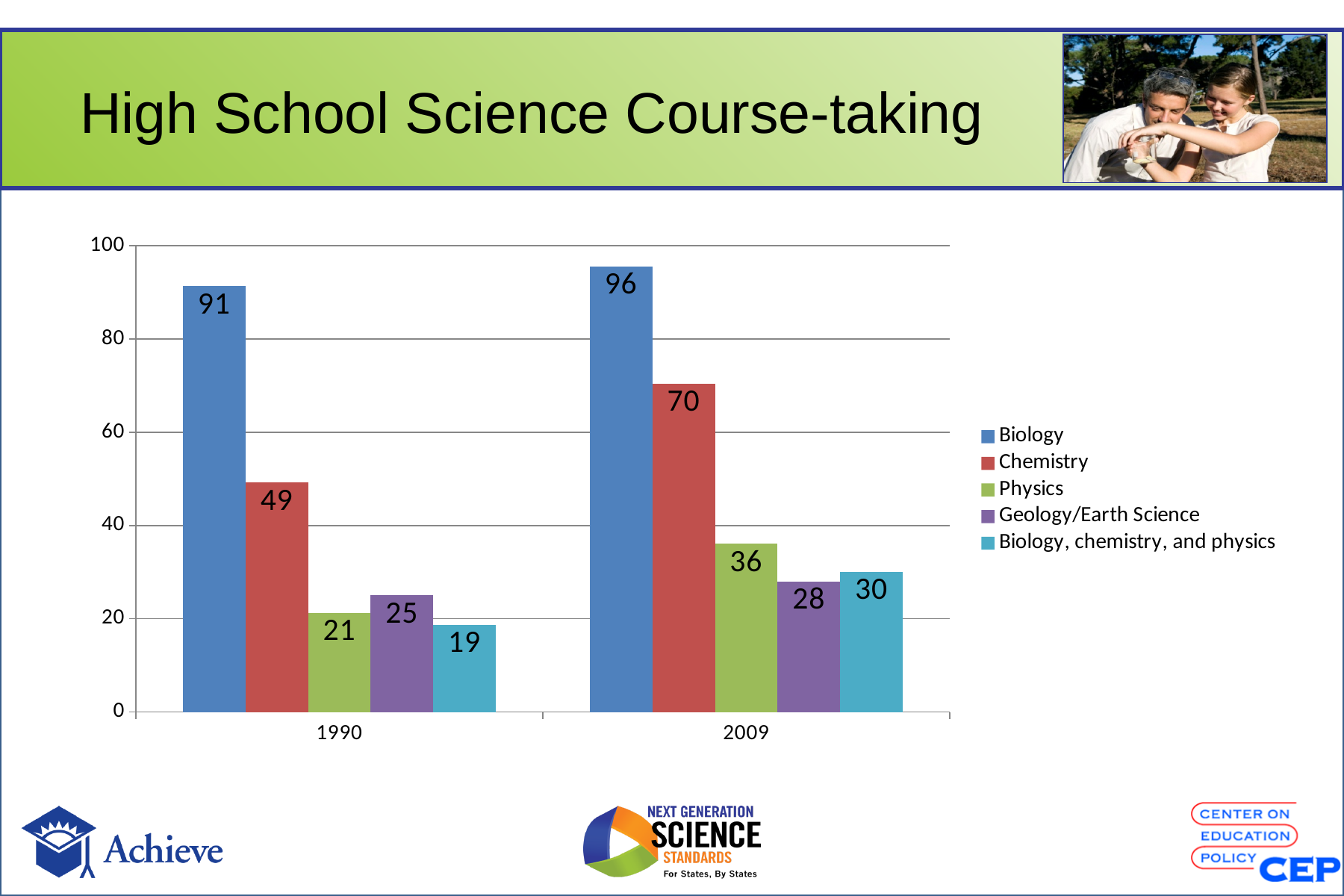
Does the Physics value rise or fall from 1990 to 2009? Rise What is the value for Chemistry in 2009? 70 What is the value for Biology, chemistry, and physics in 2009? 30 Which is larger, Physics in 2009 or Geology/Earth Science in 2009? Physics in 2009 Which series has the lowest value in 1990? Biology, chemistry, and physics How many series does the legend list? 5 What is the value for Biology in 1990? 91 Which series has the highest value in 2009? Biology What kind of chart is shown on the slide? Bar chart What is the difference between the Chemistry values for 2009 and 1990? 21 Is the value for Chemistry in 1990 greater or less than 40? greater What is the value for Geology/Earth Science in 1990? 25